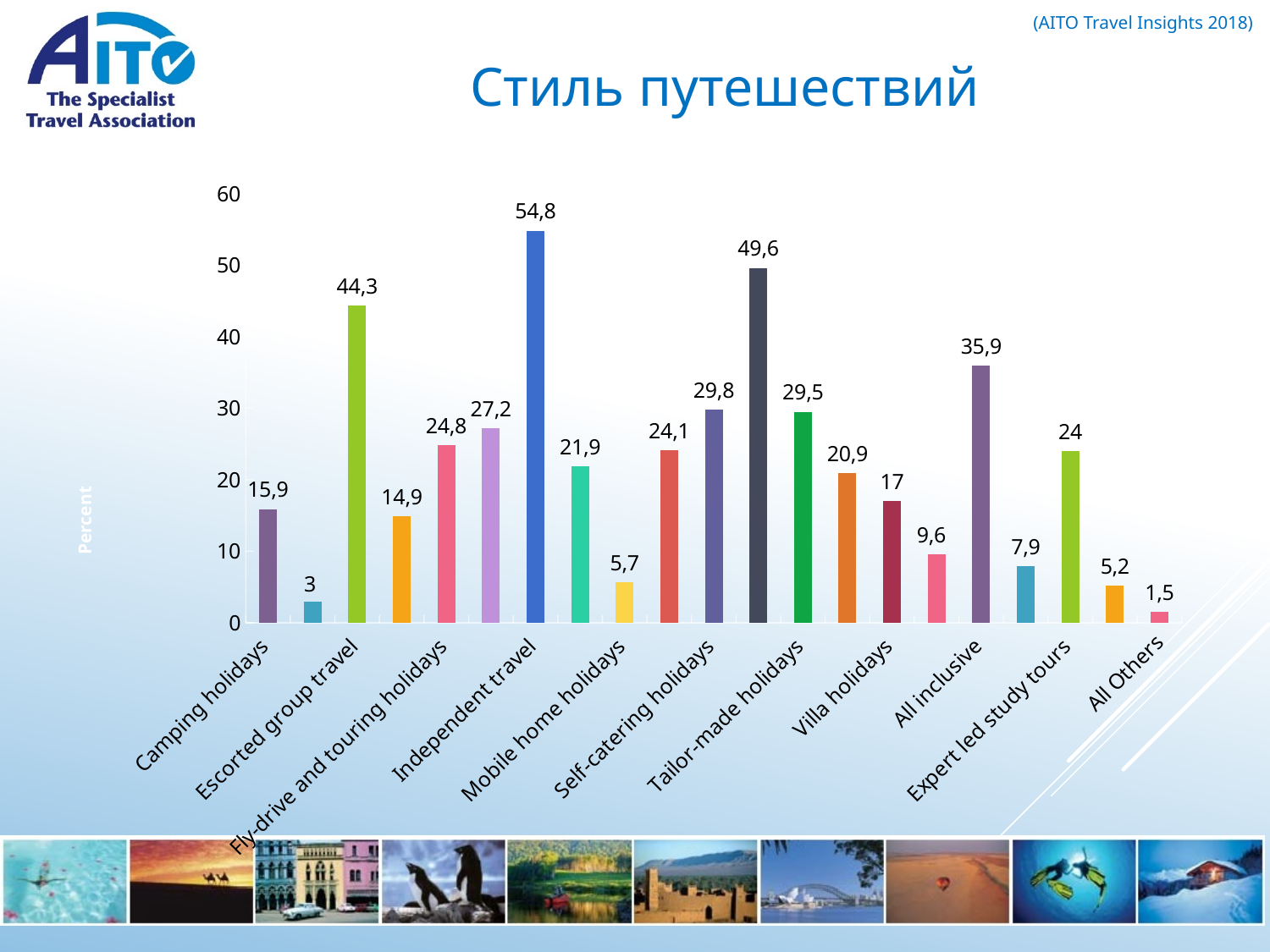
How many category labels are shown on the x axis? 11 Which labelled category has the lowest value? All Others What is the value for All inclusive? 35,9 What kind of chart is shown on the slide? bar chart What is the value for Villa holidays? 17 What is the value for Independent travel? 54,8 What is the difference between the values for Independent travel and Escorted group travel? 10,5 Is the value for Expert led study tours greater or less than 20? greater Which labelled category has the highest value? Independent travel Which is larger, the value for Self-catering holidays or the value for Tailor-made holidays? Self-catering holidays What is the value for Escorted group travel? 44,3 What is the title of the chart? Стиль путешествий